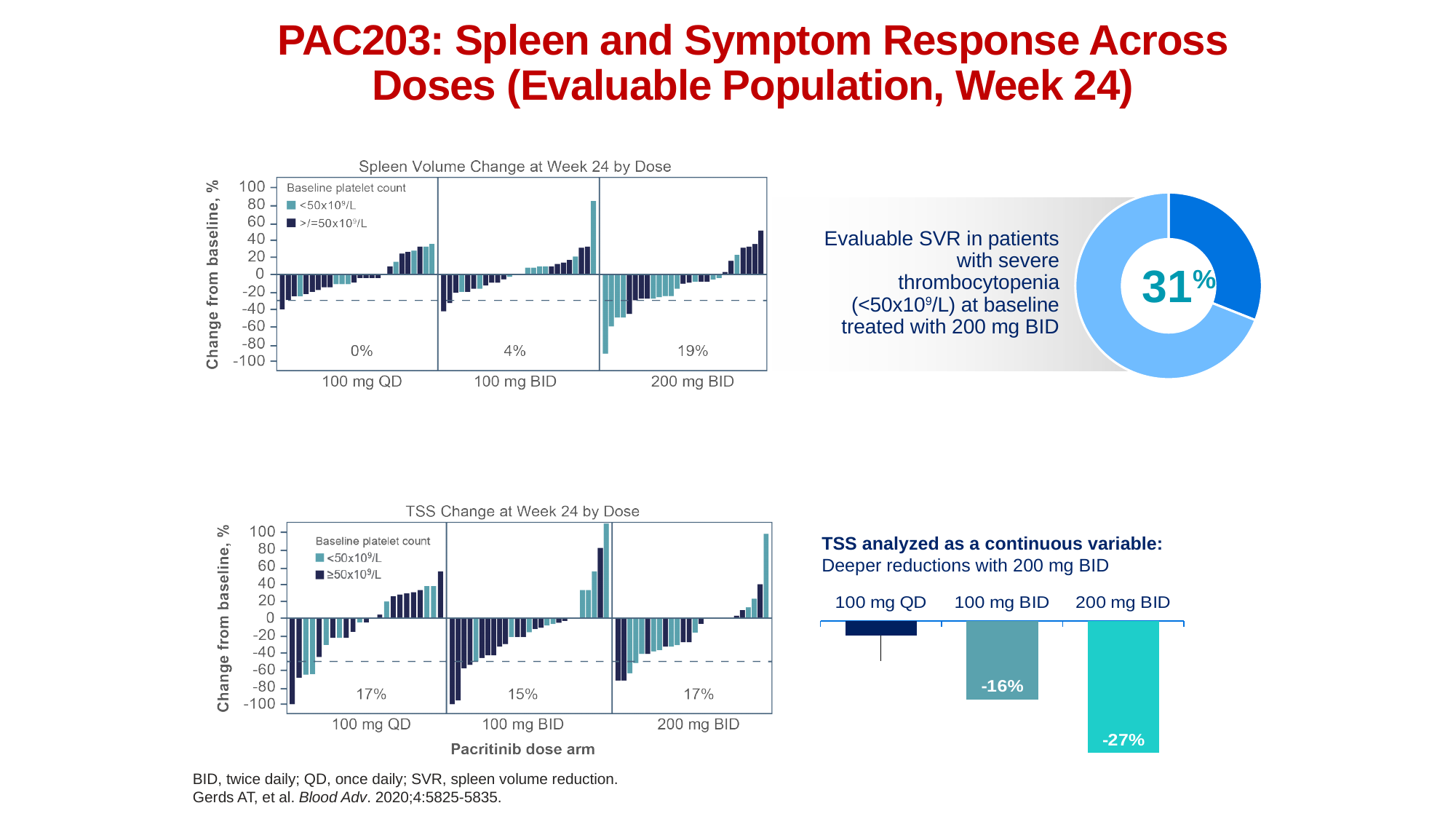
In the Spleen Volume Change at Week 24 by Dose chart, what response rate is shown for the 100 mg BID arm? 4% In the bar chart at the bottom right (TSS analyzed as a continuous variable), what is the value for 100 mg BID? -16% How many baseline platelet count groups does the legend of the Spleen Volume Change at Week 24 by Dose chart list? 2 In the TSS Change at Week 24 by Dose chart, what response rate is shown for the 100 mg BID arm? 15% In the TSS Change at Week 24 by Dose chart, how many dose arms are shown? 3 What percentage is shown in the centre of the donut chart on the right of the slide? 31% In the TSS Change at Week 24 by Dose chart, which dose arm has the lowest response rate? 100 mg BID In the Spleen Volume Change at Week 24 by Dose chart, which dose arm has the highest response rate? 200 mg BID In the bar chart at the bottom right (TSS analyzed as a continuous variable), what is the difference between the 100 mg BID and 200 mg BID values? 11 percentage points In the Spleen Volume Change at Week 24 by Dose chart, what response rate is shown for the 200 mg BID arm? 19% In the bar chart at the bottom right (TSS analyzed as a continuous variable), what is the value for 200 mg BID? -27% In the Spleen Volume Change at Week 24 by Dose chart, what response rate is shown for the 100 mg QD arm? 0%